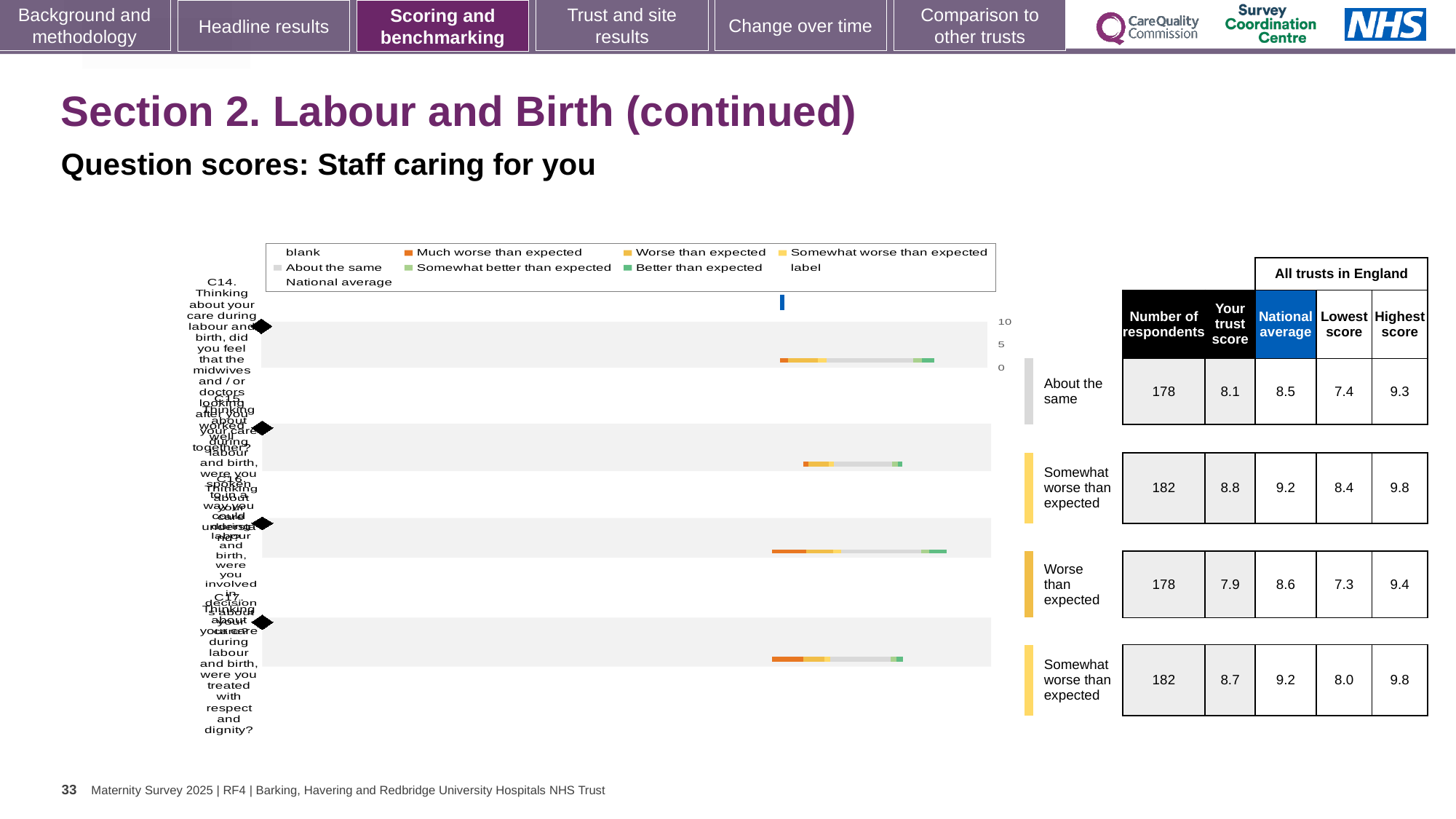
What is the national average for the last question, C17 (treated with respect and dignity)? 9.2 Is the trust score for the first question, C14, greater or less than 5 on the axis? greater What kind of chart is shown on the slide? bar chart How many questions (rows) are plotted in the chart? 4 What is the difference between the national average and the trust score for the first question, C14? 0.4 How many respondents answered the last question, C17? 182 Which of the four questions has the highest trust score? the second question (8.8) What is the heading above the chart? Question scores: Staff caring for you What colour does the legend use for "Better than expected"? green Which benchmark category is the first question, C14, placed in? About the same Which of the four questions has the lowest trust score? the third question (7.9) What is the trust score for the first question, C14 (midwives and/or doctors worked well together)? 8.1